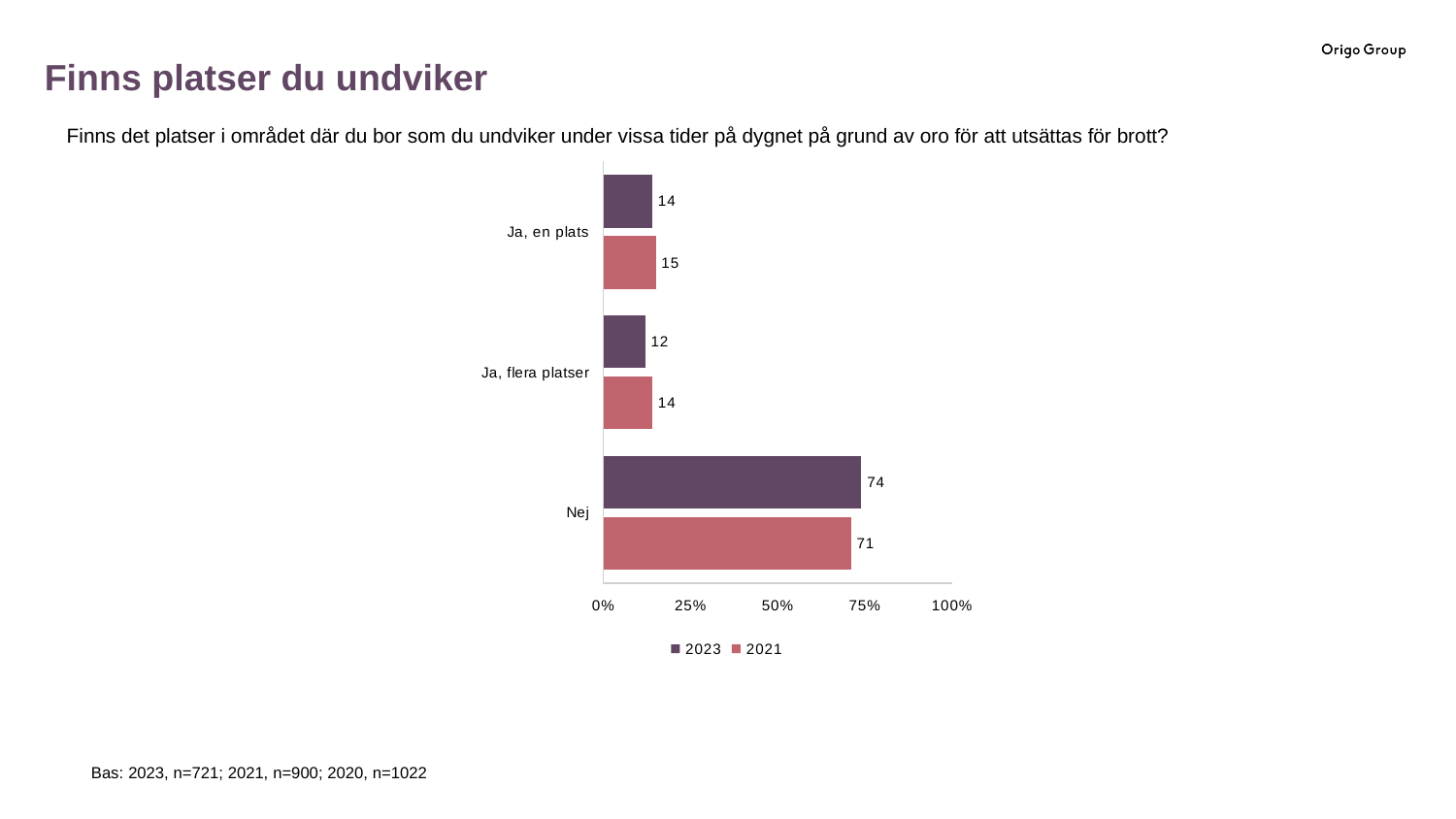
What is the 2021 value for "Nej"? 71 What is the difference between the 2023 and 2021 values for "Nej"? 3 Which category has the lowest 2021 value? Ja, flera platser How many categories are shown on the chart? 3 How many series does the legend list? 2 What is the 2023 value for "Ja, flera platser"? 12 Which category has the highest 2023 value? Nej What kind of chart is shown on the slide? Bar chart Which is larger for "Ja, flera platser": the 2023 value or the 2021 value? 2021 What is the 2023 value for "Nej"? 74 What is the 2021 value for "Ja, en plats"? 15 Is the 2023 value for "Nej" greater or less than 50%? greater